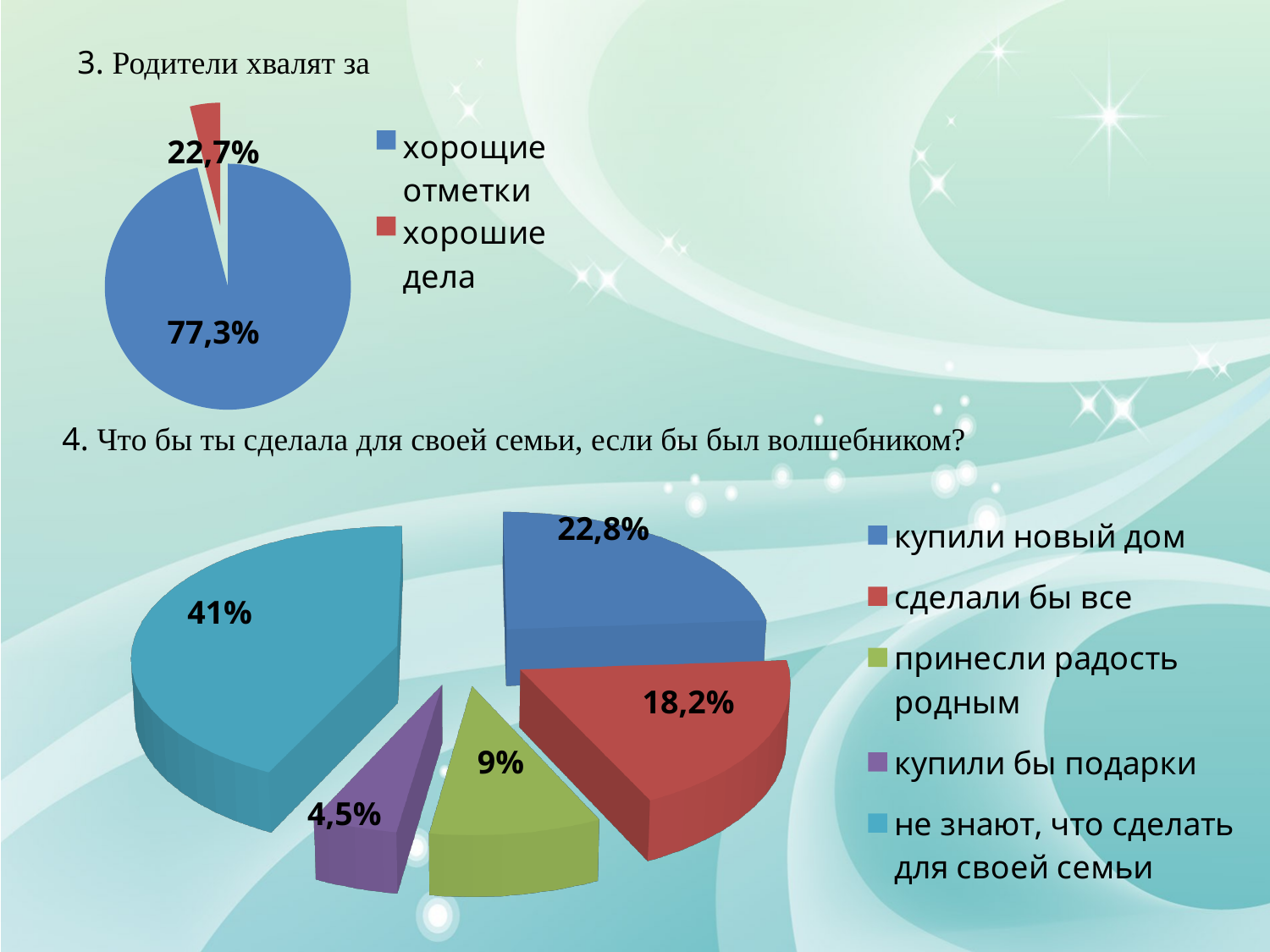
In the top chart 'Родители хвалят за', what percentage is shown for 'хорошие отметки'? 77,3% In the bottom chart, what percentage is shown for 'купили новый дом'? 22,8% In the bottom chart, how many categories does the legend list? 5 In the bottom chart, which category has the largest share? не знают, что сделать для своей семьи In the top chart 'Родители хвалят за', what percentage is shown for 'хорошие дела'? 22,7% In the bottom chart, which category has the smallest share? купили бы подарки In the bottom chart, what percentage is shown for 'не знают, что сделать для своей семьи'? 41% In the bottom chart, which is larger: 'сделали бы все' or 'принесли радость родным'? сделали бы все In the bottom chart, what percentage is shown for 'купили бы подарки'? 4,5% In the top chart 'Родители хвалят за', which category has the larger share? хорошие отметки In the top chart 'Родители хвалят за', how many categories does the legend list? 2 What type of chart is the top chart 'Родители хвалят за'? pie chart